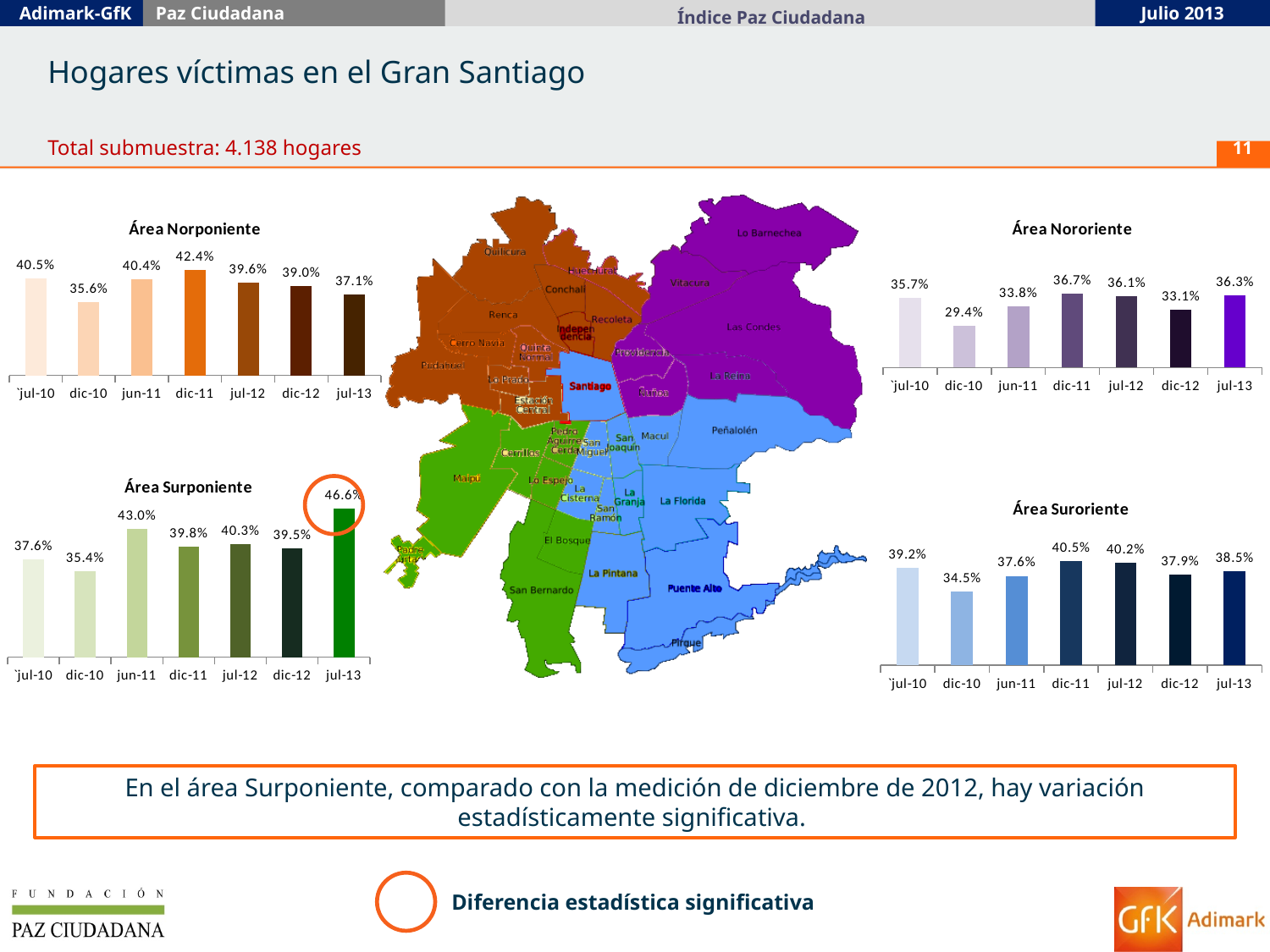
In the Área Norponiente chart, what is the value for dic-11? 42.4% How many periods are shown on the x axis of the Área Suroriente chart? 7 In the Área Surponiente chart, what is the value for jul-13? 46.6% In the Área Nororiente chart, which is larger, the value for dic-11 or the value for dic-12? dic-11 How many bar charts are shown on the slide? 4 In the Área Surponiente chart, which period has the highest value? jul-13 In the Área Nororiente chart, which period has the lowest value? dic-10 In the Área Norponiente chart, which is larger, the value for jul-10 or the value for jul-13? jul-10 In the Área Suroriente chart, what is the difference between the dic-11 value and the dic-10 value? 6.0% What kind of chart is the Área Nororiente chart? Bar chart In the Área Surponiente chart, what is the difference between jul-13 and dic-12? 7.1% In the Área Suroriente chart, what is the value for jun-11? 37.6%